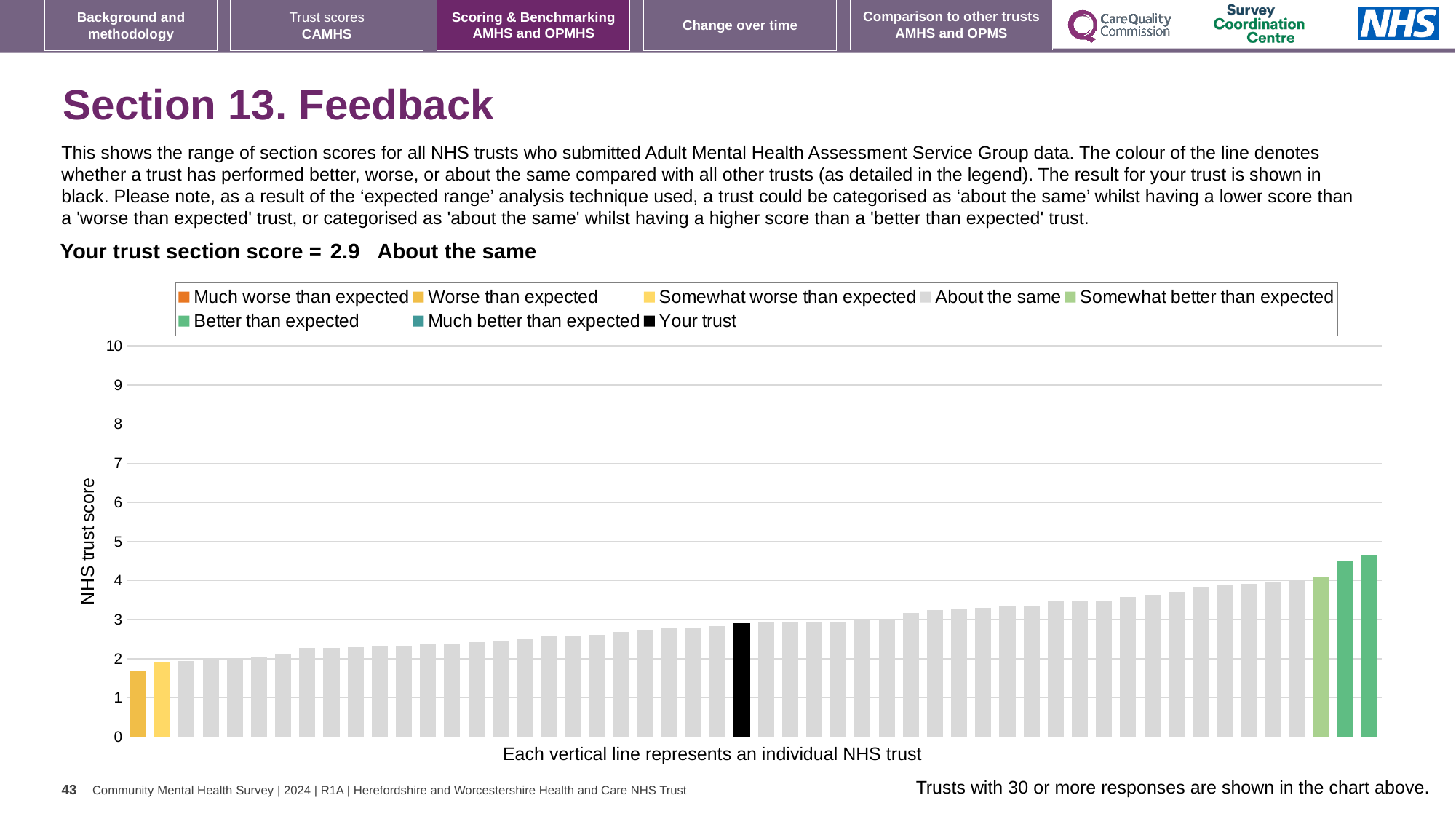
How is your trust's section score categorised compared with other trusts? About the same What is the label on the y axis of the chart? NHS trust score Is the value of the shortest bar in the chart greater or less than 2? less What is the section score for your trust shown on the slide? 2.9 Is the value of the tallest bar in the chart greater or less than 5? less What colour is used for the bar representing your trust? black Is the value for your trust (the black bar) greater or less than 2? greater How many bars in the chart are coloured green (better than expected categories)? 3 What kind of chart is shown on the slide? bar chart Do the bar values rise or fall from left to right along the x axis? rise How many entries does the chart legend list? 8